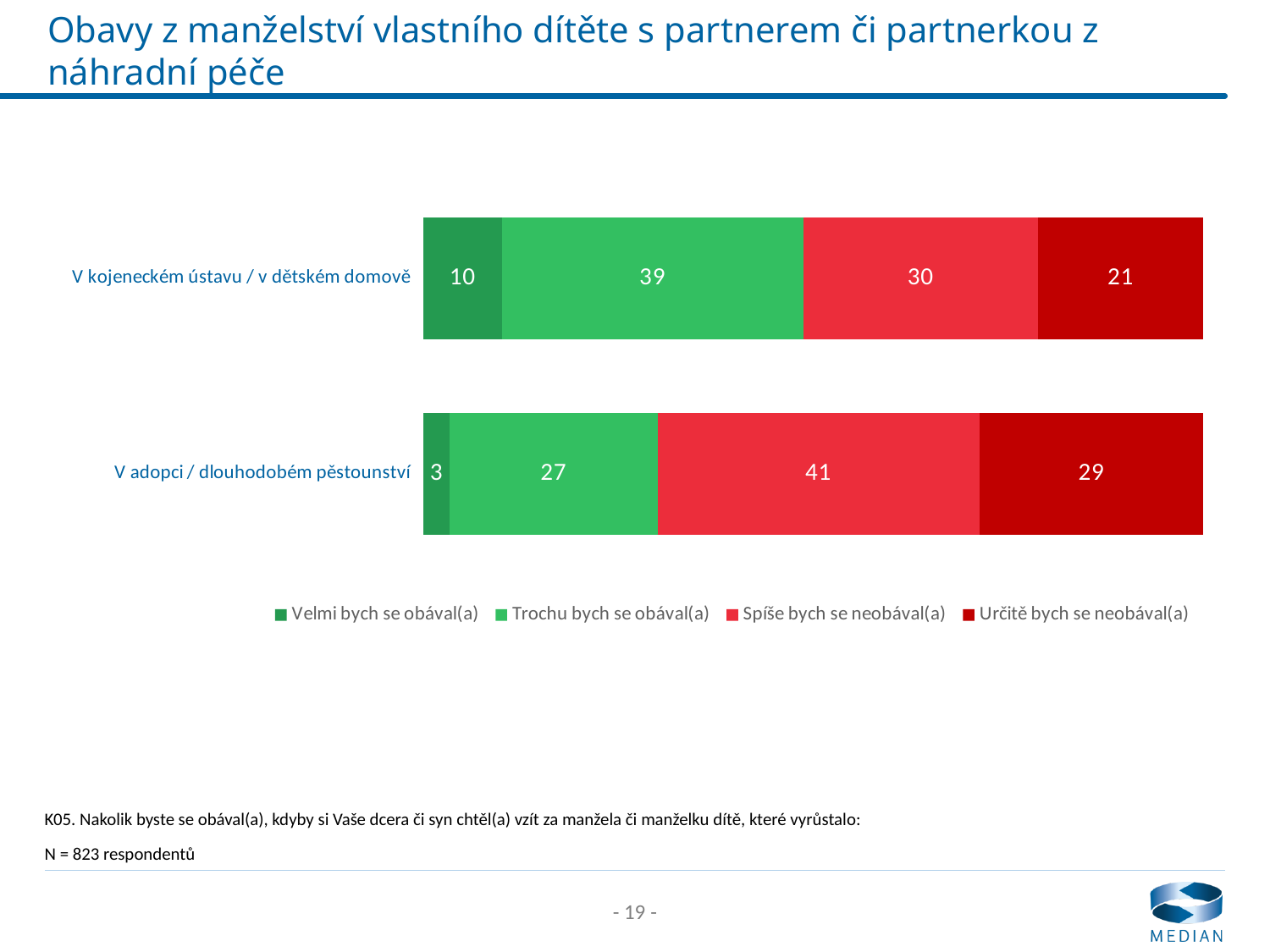
What is the value for "Trochu bych se obával(a)" in the "V kojeneckém ústavu / v dětském domově" bar? 39 What is the difference between the "Určitě bych se neobával(a)" values for "V adopci / dlouhodobém pěstounství" and "V kojeneckém ústavu / v dětském domově"? 8 What is the value for "Velmi bych se obával(a)" in the "V adopci / dlouhodobém pěstounství" bar? 3 What is the value for "Určitě bych se neobával(a)" in the "V kojeneckém ústavu / v dětském domově" bar? 21 Which segment is the largest in the "V adopci / dlouhodobém pěstounství" bar? Spíše bych se neobával(a) Which segment is the smallest in the "V kojeneckém ústavu / v dětském domově" bar? Velmi bych se obával(a) How many categories are shown in the chart? 2 What is the value for "Spíše bych se neobával(a)" in the "V adopci / dlouhodobém pěstounství" bar? 41 How many series does the legend list? 4 What kind of chart is shown on the slide? Stacked bar chart What is the total of the "V kojeneckém ústavu / v dětském domově" stacked bar? 100 Which category has the larger value for "Trochu bych se obával(a)"? V kojeneckém ústavu / v dětském domově